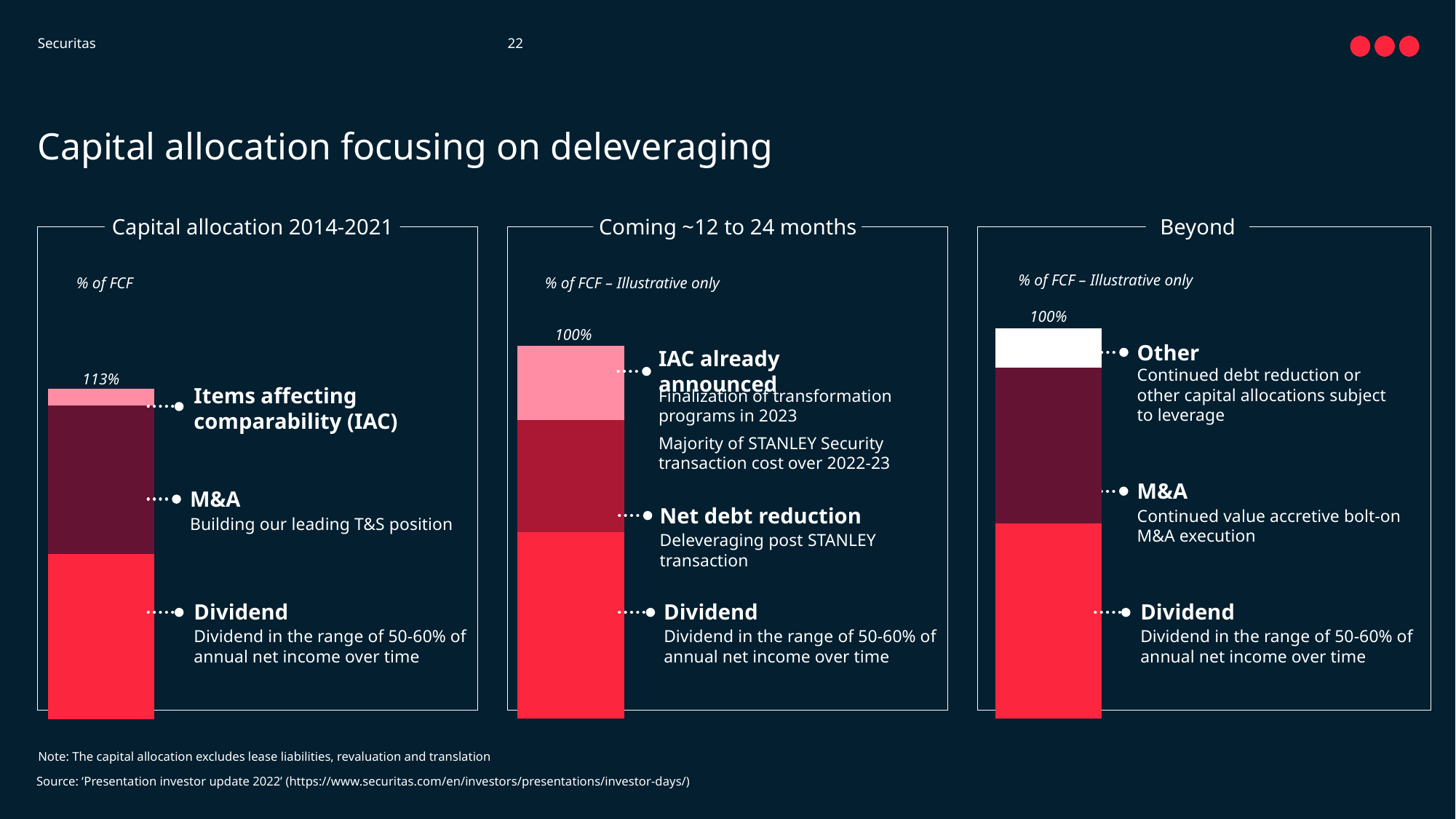
In the 'Coming ~12 to 24 months' chart, which segment is the largest? Dividend In the 'Capital allocation 2014-2021' chart, which segment is the smallest? Items affecting comparability (IAC) In the 'Beyond' chart, what total value is printed above the stacked bar? 100% In the 'Capital allocation 2014-2021' chart, what total value is printed above the stacked bar? 113% How many stacked bar charts are shown on the slide? 3 In the 'Capital allocation 2014-2021' chart, how many segments make up the stacked bar? 3 In the 'Coming ~12 to 24 months' chart, what total value is printed above the stacked bar? 100% What kind of chart is used in the 'Capital allocation 2014-2021' panel? Stacked bar chart In the 'Coming ~12 to 24 months' chart, which segment is the smallest? IAC already announced In the 'Beyond' chart, which segment is the smallest? Other In the 'Capital allocation 2014-2021' chart, which segment is larger: Dividend or M&A? Dividend In the 'Capital allocation 2014-2021' chart, which segment is the largest? Dividend